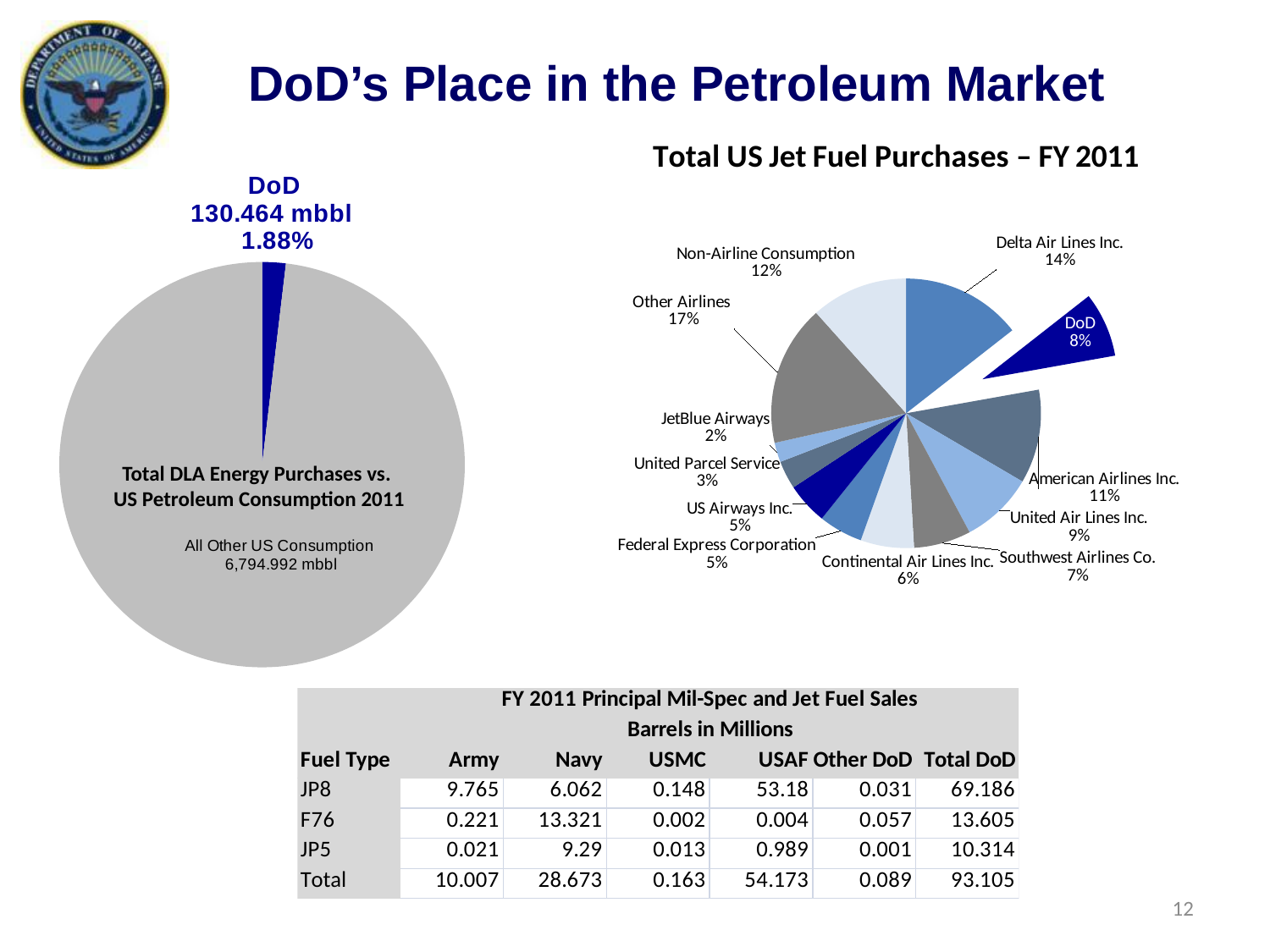
In the 'Total US Jet Fuel Purchases – FY 2011' chart, what percentage is shown for Non-Airline Consumption? 12% In the 'Total US Jet Fuel Purchases – FY 2011' chart, which slice has the largest share? Other Airlines How many slices does the 'Total US Jet Fuel Purchases – FY 2011' pie chart have? 12 In the 'Total US Jet Fuel Purchases – FY 2011' chart, what percentage is shown for Delta Air Lines Inc.? 14% In the 'Total US Jet Fuel Purchases – FY 2011' chart, which slice has the smallest share? JetBlue Airways In the 'Total DLA Energy Purchases vs. US Petroleum Consumption 2011' chart, what share does DoD hold? 1.88% How many slices does the 'Total DLA Energy Purchases vs. US Petroleum Consumption 2011' pie chart have? 2 In the 'Total DLA Energy Purchases vs. US Petroleum Consumption 2011' chart, what value is shown for All Other US Consumption? 6,794.992 mbbl In the 'Total US Jet Fuel Purchases – FY 2011' chart, what share does DoD hold? 8% In the 'Total US Jet Fuel Purchases – FY 2011' chart, which is larger: American Airlines Inc. or United Air Lines Inc.? American Airlines Inc. In the 'Total US Jet Fuel Purchases – FY 2011' chart, how many percentage points larger is Delta Air Lines Inc. than DoD? 6% What type of chart is the 'Total US Jet Fuel Purchases – FY 2011' chart? pie chart